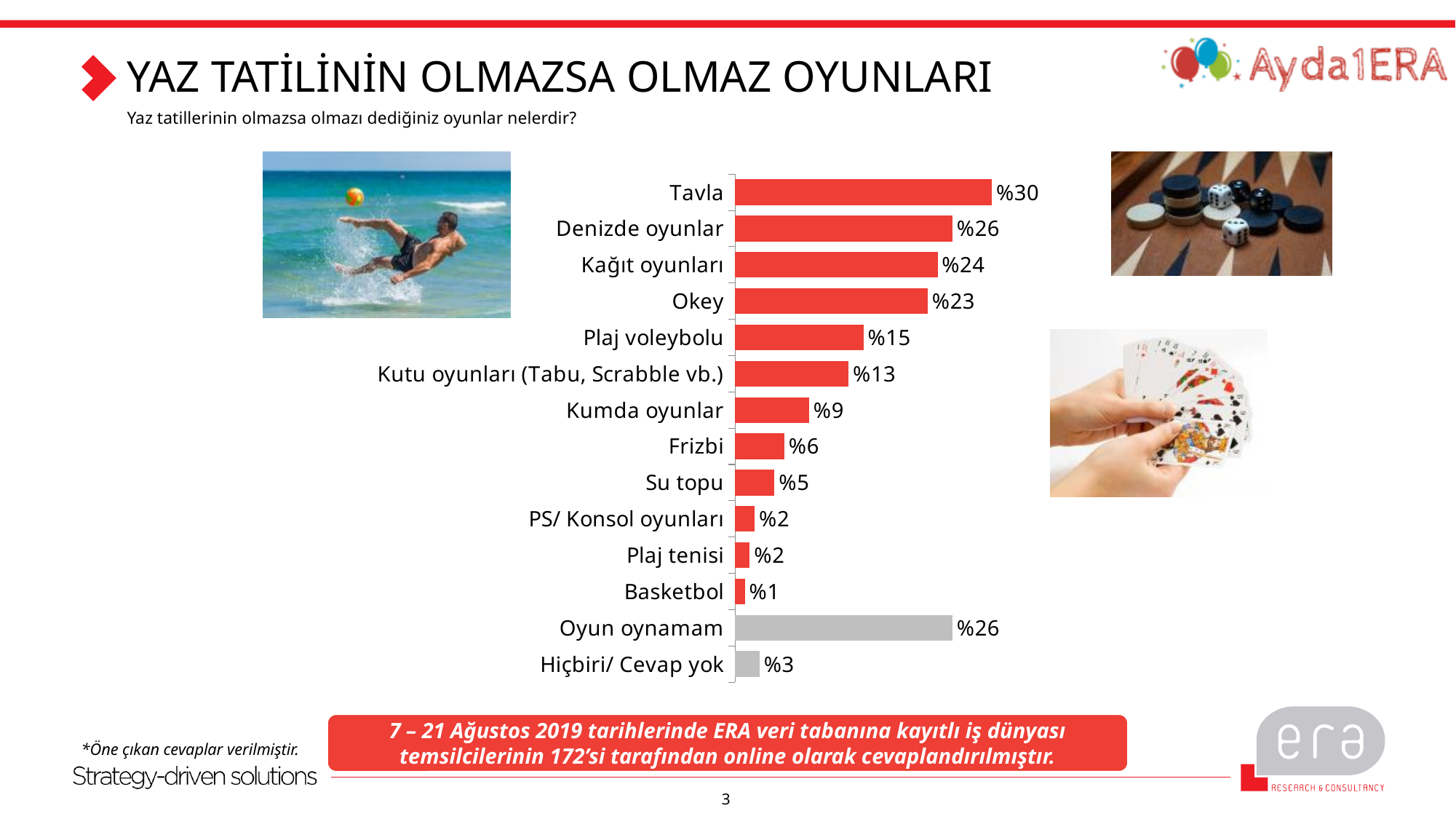
How many categories are shown in the chart? 14 What is the value for Oyun oynamam? %26 Which category has the highest value? Tavla Which is larger, the value for Denizde oyunlar or the value for Okey? Denizde oyunlar What kind of chart is shown on the slide? Bar chart Which is larger, the value for Frizbi or the value for Su topu? Frizbi What is the value for Plaj voleybolu? %15 Which category has the lowest value? Basketbol What is the value for Tavla? %30 What is the difference between the values for Kağıt oyunları and Kumda oyunlar? 15 percentage points What is the value for Kutu oyunları (Tabu, Scrabble vb.)? %13 What is the difference between the values for Tavla and Okey? 7 percentage points